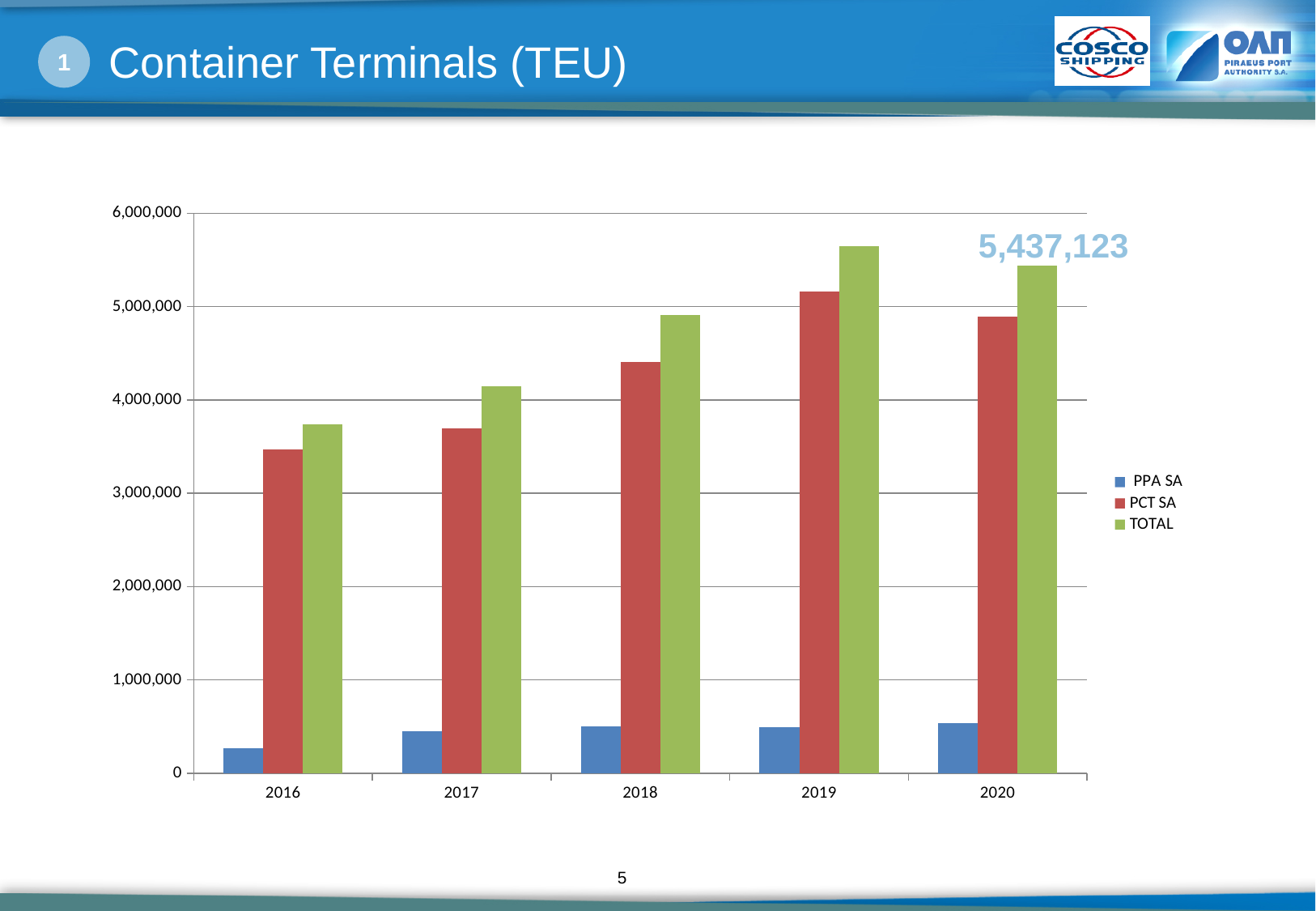
In which year is the TOTAL bar highest? 2019 In which year is the TOTAL bar lowest? 2016 Which is larger, the PCT SA value for 2018 or for 2017? 2018 What is the TOTAL value labelled for 2020? 5,437,123 In which year is the PPA SA bar lowest? 2016 How many years are shown on the x axis? 5 How many series does the legend list? 3 Is the PPA SA value for 2020 greater or less than 1,000,000? less Does the TOTAL value rise or fall from 2016 to 2019? rise Is the PCT SA value for 2019 greater or less than 5,000,000? greater Is the TOTAL value for 2016 greater or less than 4,000,000? less What kind of chart is shown on the slide? bar chart